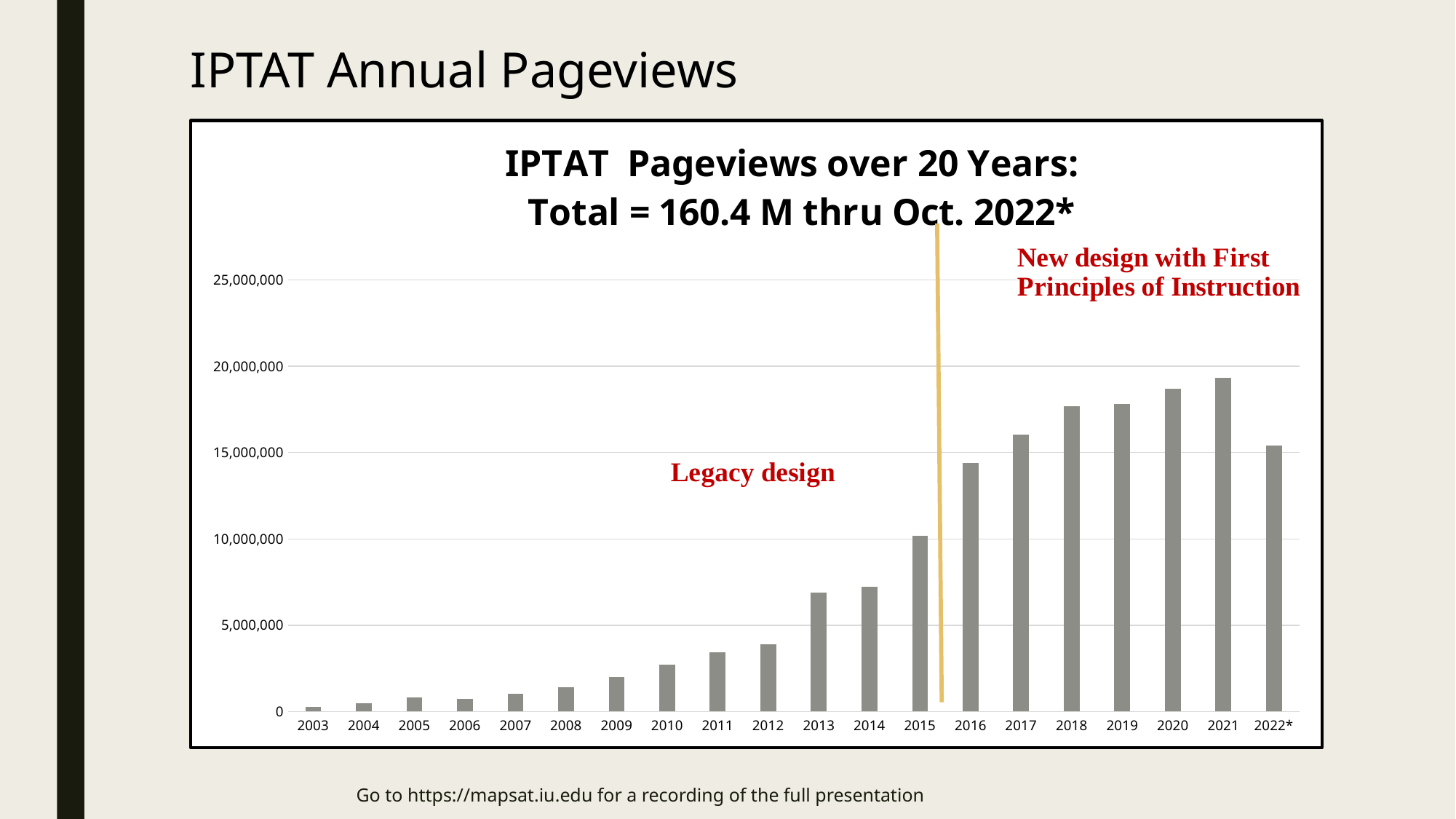
What total pageviews figure is stated in the chart title? 160.4 M thru Oct. 2022* Which year has the lowest number of pageviews? 2003 Is the value for 2013 greater or less than 5,000,000? greater What kind of chart is shown on the slide? Bar chart Is the value for 2017 greater or less than 15,000,000? greater Is the value for 2021 greater or less than 20,000,000? less Which year has the highest number of pageviews? 2021 Which year has more pageviews, 2016 or 2017? 2017 Do pageviews generally rise or fall from 2003 to 2021? Rise How many years are plotted on the x axis of the chart? 20